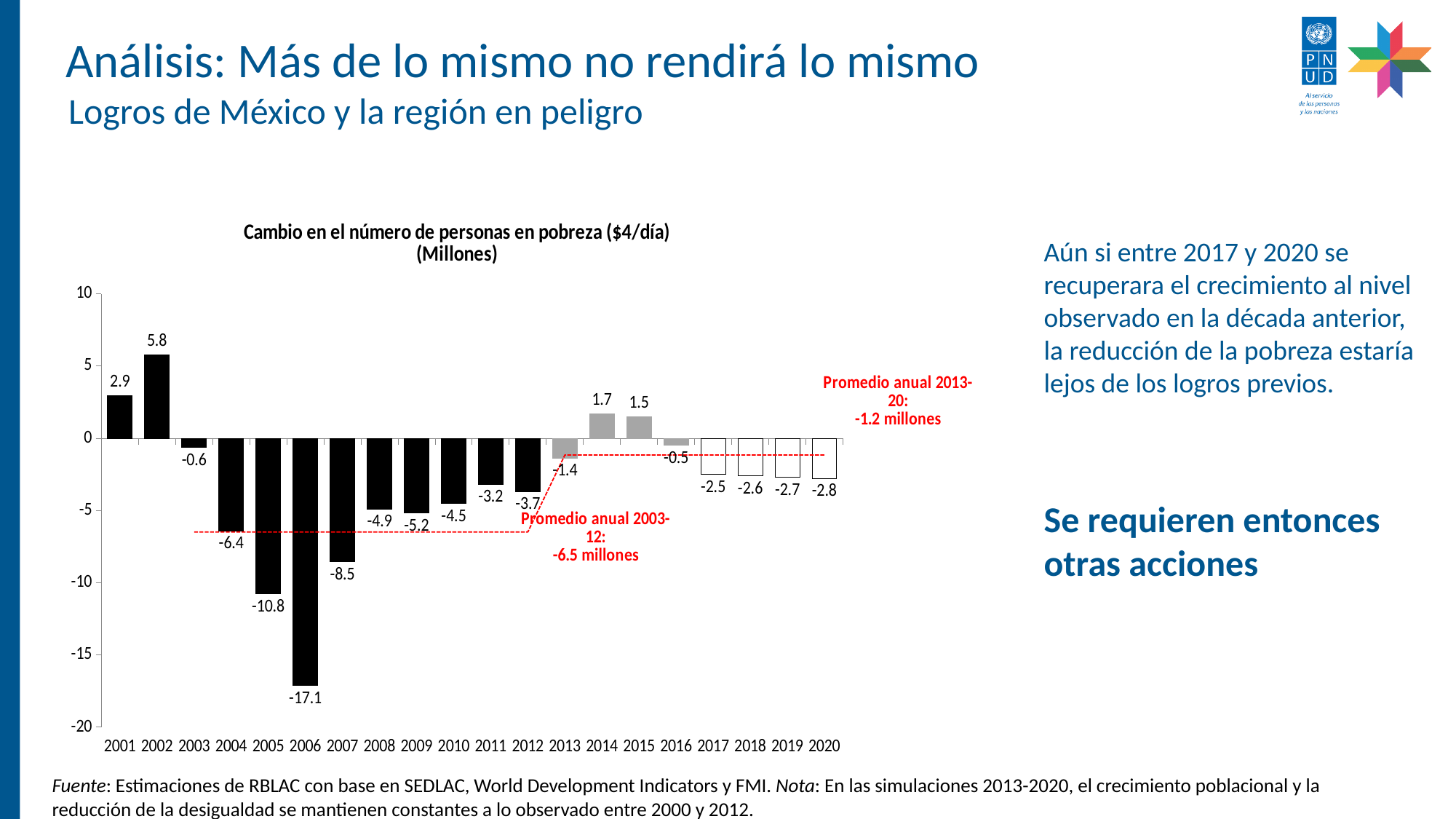
What is the value for 2020? -2.8 What is the value for 2006? -17.1 What is the difference between the values for 2005 and 2007? 2.3 What is the value for 2014? 1.7 What annual average is given for 2003-12 in the chart annotation? -6.5 millones Which year has the lowest value? 2006 What kind of chart is shown? Bar chart Which year has the highest value? 2002 Do the values rise or fall from 2017 to 2020? Fall Which is larger, the value for 2014 or the value for 2015? 2014 What is the value for 2002? 5.8 How many years are shown on the x axis? 20